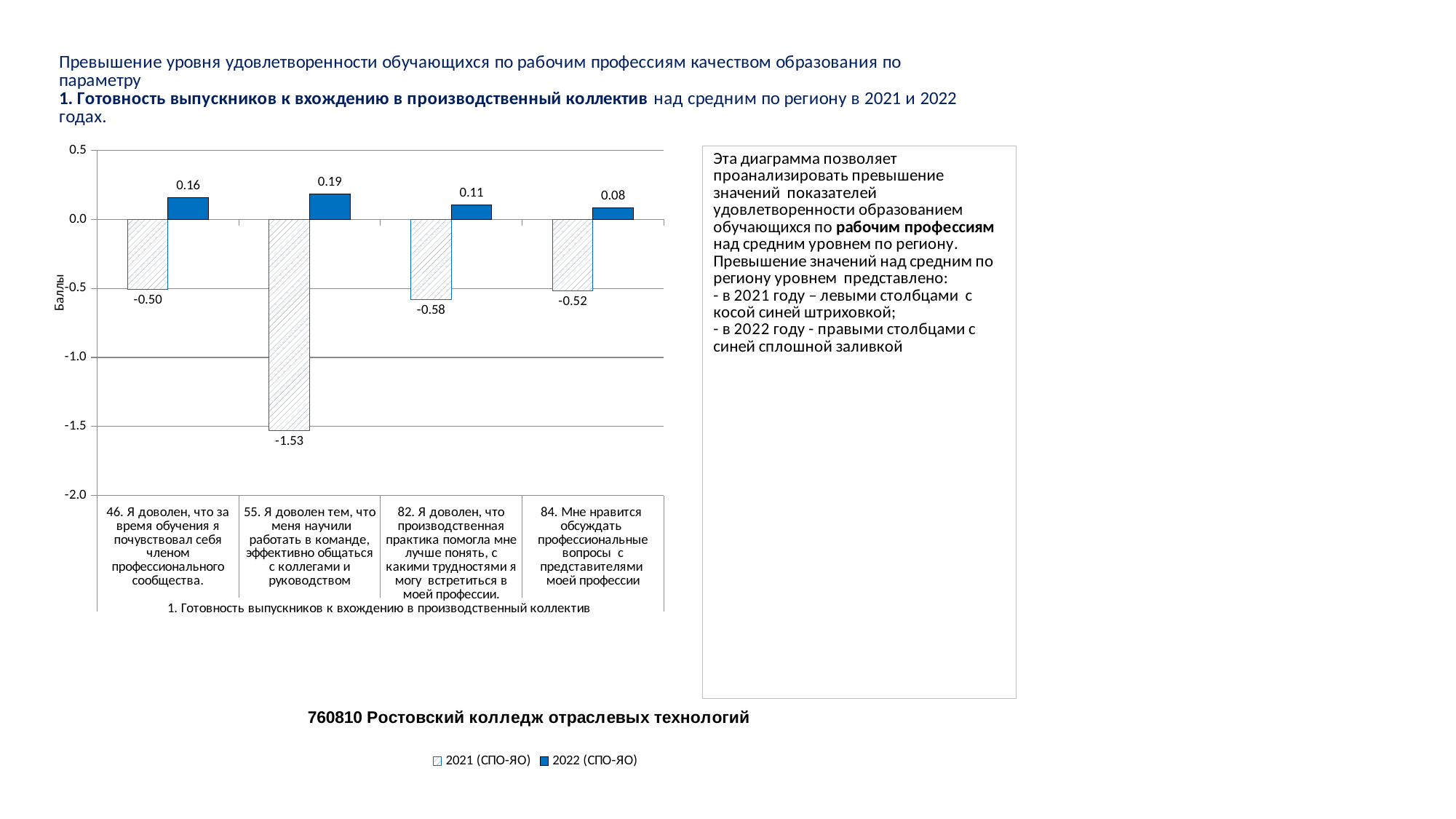
What is the difference between the 2022 and 2021 values for category 46? 0.66 What is the value for 2022 (СПО-ЯО) for category 84 (Мне нравится обсуждать профессиональные вопросы с представителями моей профессии)? 0.08 Which is larger: the 2022 value for category 82 or the 2022 value for category 84? Category 82 (0.11) How many series does the legend list? 2 Which category has the lowest value for the 2021 (СПО-ЯО) series? 55. Я доволен тем, что меня научили работать в команде, эффективно общаться с коллегами и руководством Is the 2021 value for category 55 greater or less than -1.0? less What type of chart is shown on the slide? Bar chart What is the value for 2021 (СПО-ЯО) for category 55 (Я доволен тем, что меня научили работать в команде)? -1.53 What is the value for 2022 (СПО-ЯО) for category 46 (Я доволен, что за время обучения я почувствовал себя членом профессионального сообщества)? 0.16 Which category has the highest value for the 2022 (СПО-ЯО) series? 55. Я доволен тем, что меня научили работать в команде, эффективно общаться с коллегами и руководством How many categories are shown on the x axis of the chart? 4 What is the value for 2021 (СПО-ЯО) for category 82 (Я доволен, что производственная практика помогла мне лучше понять...)? -0.58